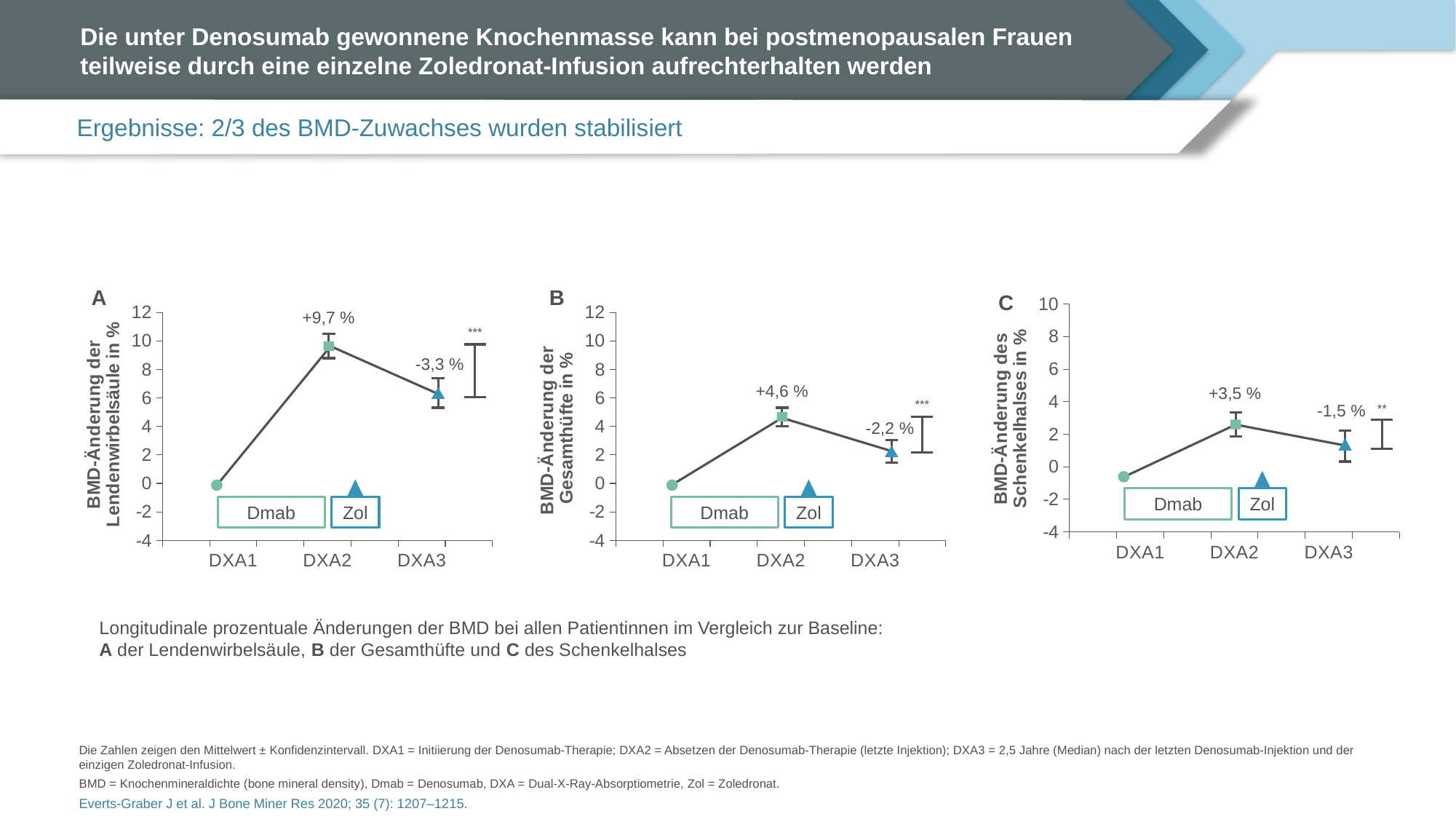
What kind of chart is chart B (Gesamthüfte)? Line chart In chart B (Gesamthüfte), what percentage change is labelled at DXA2? +4,6 % In chart A (Lendenwirbelsäule), what percentage change is labelled between DXA2 and DXA3? -3,3 % In chart B (Gesamthüfte), what percentage change is labelled between DXA2 and DXA3? -2,2 % How many DXA time points are plotted in chart C (Schenkelhals)? 3 In chart A (Lendenwirbelsäule), at which DXA time point is the BMD change highest? DXA2 In chart A (Lendenwirbelsäule), is the value at DXA3 greater or less than 4? greater In chart C (Schenkelhals), at which DXA time point is the BMD change lowest? DXA1 Which labelled DXA2 increase is larger: chart A (Lendenwirbelsäule) or chart B (Gesamthüfte)? Chart A (Lendenwirbelsäule) In chart B (Gesamthüfte), is the value at DXA3 greater or less than 4? less In chart C (Schenkelhals), what percentage change is labelled between DXA2 and DXA3? -1,5 % In chart A (Lendenwirbelsäule), what percentage change is labelled at DXA2? +9,7 %